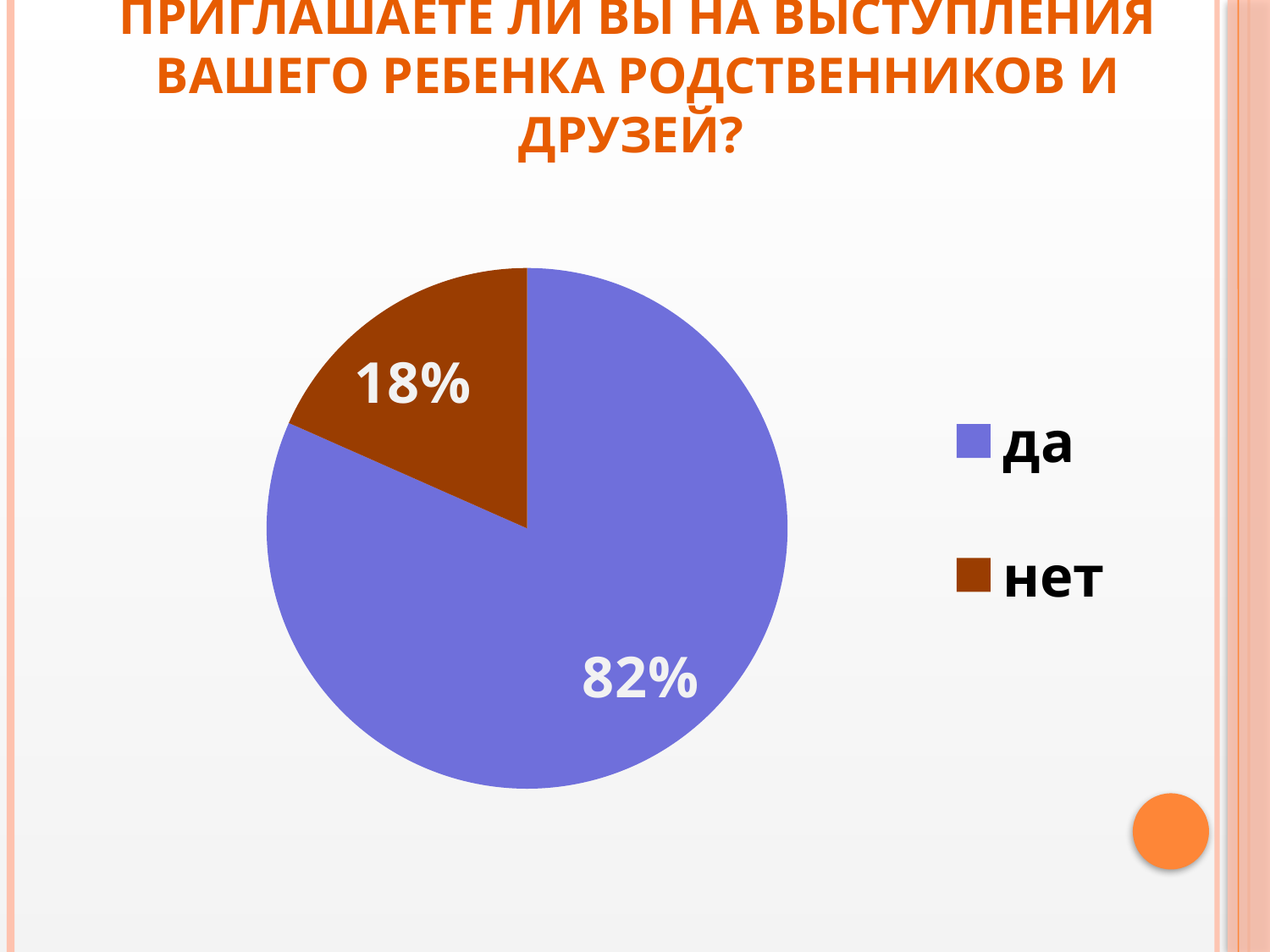
What is the difference in percentage points between "да" and "нет"? 64 What colour is the slice for "да"? blue What kind of chart is shown on the slide? pie chart Which category has the largest slice of the pie? да Which is larger, the share for "да" or the share for "нет"? да What colour is the slice for "нет"? brown What share of the pie does "нет" take? 18% How many slices does the pie chart have? 2 What share of the pie does "да" take? 82% How many entries does the legend list? 2 Which category has the smallest slice of the pie? нет